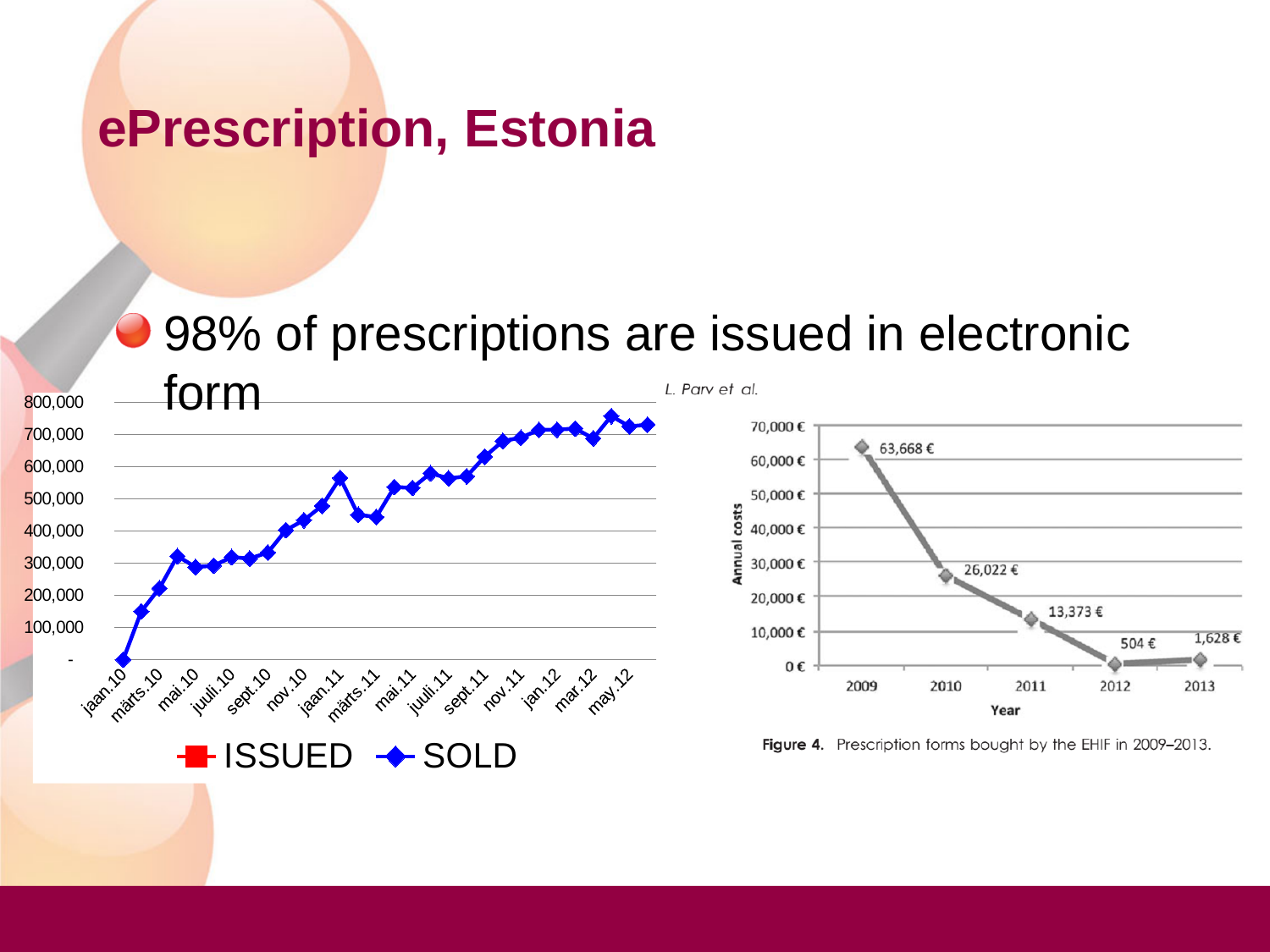
In the right-hand chart (Figure 4), what is the annual cost for 2009? 63,668 € In the right-hand chart (Figure 4), which year has the highest annual cost? 2009 In the right-hand chart (Figure 4), what is the annual cost for 2011? 13,373 € In the left-hand chart, is the SOLD value for may.12 greater or less than 700,000? greater In the right-hand chart (Figure 4), what is the annual cost for 2013? 1,628 € In the left-hand chart, how many series does the legend list? 2 In the right-hand chart (Figure 4), which year has the larger annual cost, 2012 or 2013? 2013 In the right-hand chart (Figure 4), what is the difference between the annual costs for 2009 and 2010? 37,646 € What kind of chart is the left-hand chart? Line chart In the right-hand chart (Figure 4), which year has the lowest annual cost? 2012 In the left-hand chart, do the SOLD values generally rise or fall from jaan.10 to may.12? Rise In the right-hand chart (Figure 4), how many years are plotted? 5